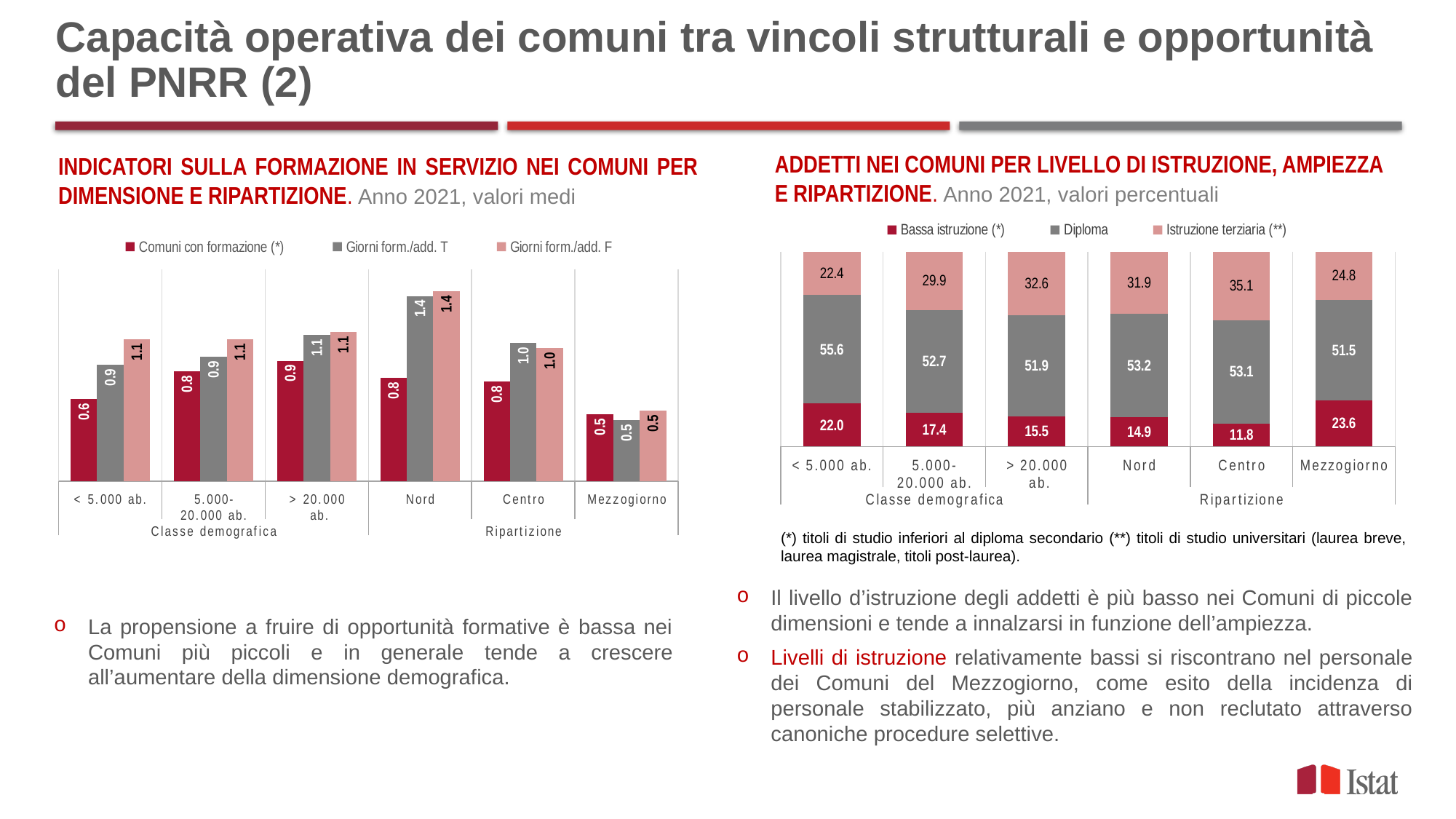
In the left chart (Indicatori sulla formazione in servizio), which category has the lowest value for Giorni form./add. F? Mezzogiorno In the right chart (Addetti nei comuni per livello di istruzione), which category has the lowest Bassa istruzione (*) value? Centro In the left chart (Indicatori sulla formazione in servizio), what is the value of Comuni con formazione (*) for < 5.000 ab.? 0.6 In the left chart (Indicatori sulla formazione in servizio), what is the value of Giorni form./add. T for Nord? 1.4 In the right chart (Addetti nei comuni per livello di istruzione), what is the Diploma share for < 5.000 ab.? 55.6 What kind of chart is the right chart (Addetti nei comuni per livello di istruzione)? Stacked bar chart In the right chart (Addetti nei comuni per livello di istruzione), what is the Bassa istruzione (*) value for Mezzogiorno? 23.6 In the right chart (Addetti nei comuni per livello di istruzione), is the Istruzione terziaria (**) value larger for Nord or for Mezzogiorno? Nord In the left chart (Indicatori sulla formazione in servizio), how many series does the legend list? 3 In the left chart (Indicatori sulla formazione in servizio), what is the difference between Giorni form./add. T for Nord and for Centro? 0.4 In the right chart (Addetti nei comuni per livello di istruzione), which category has the highest Istruzione terziaria (**) value? Centro In the left chart (Indicatori sulla formazione in servizio), which category has the highest value for Comuni con formazione (*)? > 20.000 ab.